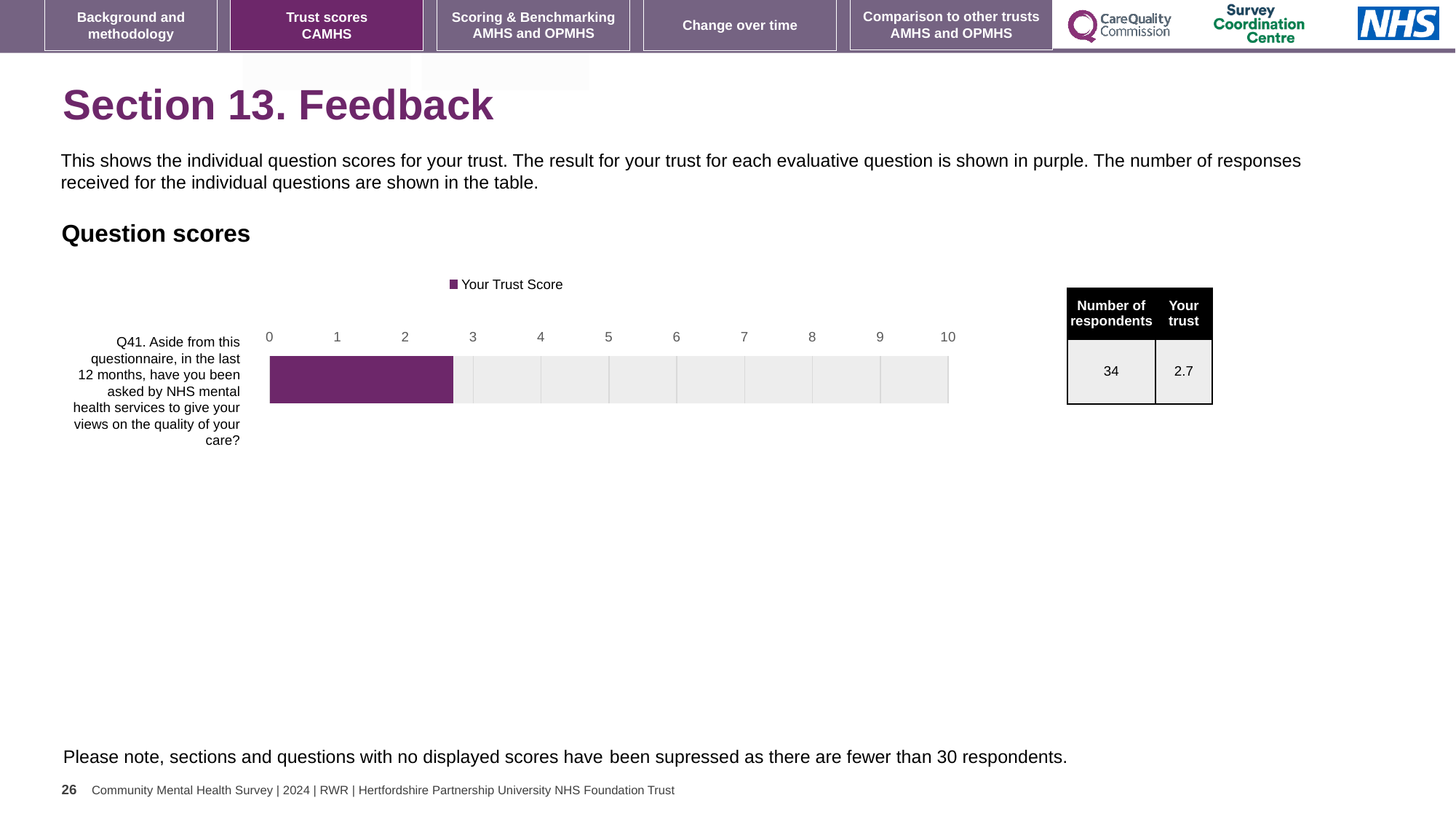
How many series does the legend of the Question scores chart list? 1 Is the trust score for Q41 greater or less than 3? less Is the trust score for Q41 greater or less than 2? greater What is the legend entry shown above the Question scores chart? Your Trust Score What kind of chart is shown under 'Question scores'? bar chart How many questions (bars) are plotted in the Question scores chart? 1 What is the highest value shown on the x axis of the Question scores chart? 10 According to the table next to the chart, what is the trust score for Q41? 2.7 According to the table next to the chart, how many respondents answered Q41? 34 Is the trust score for Q41 greater or less than 5? less